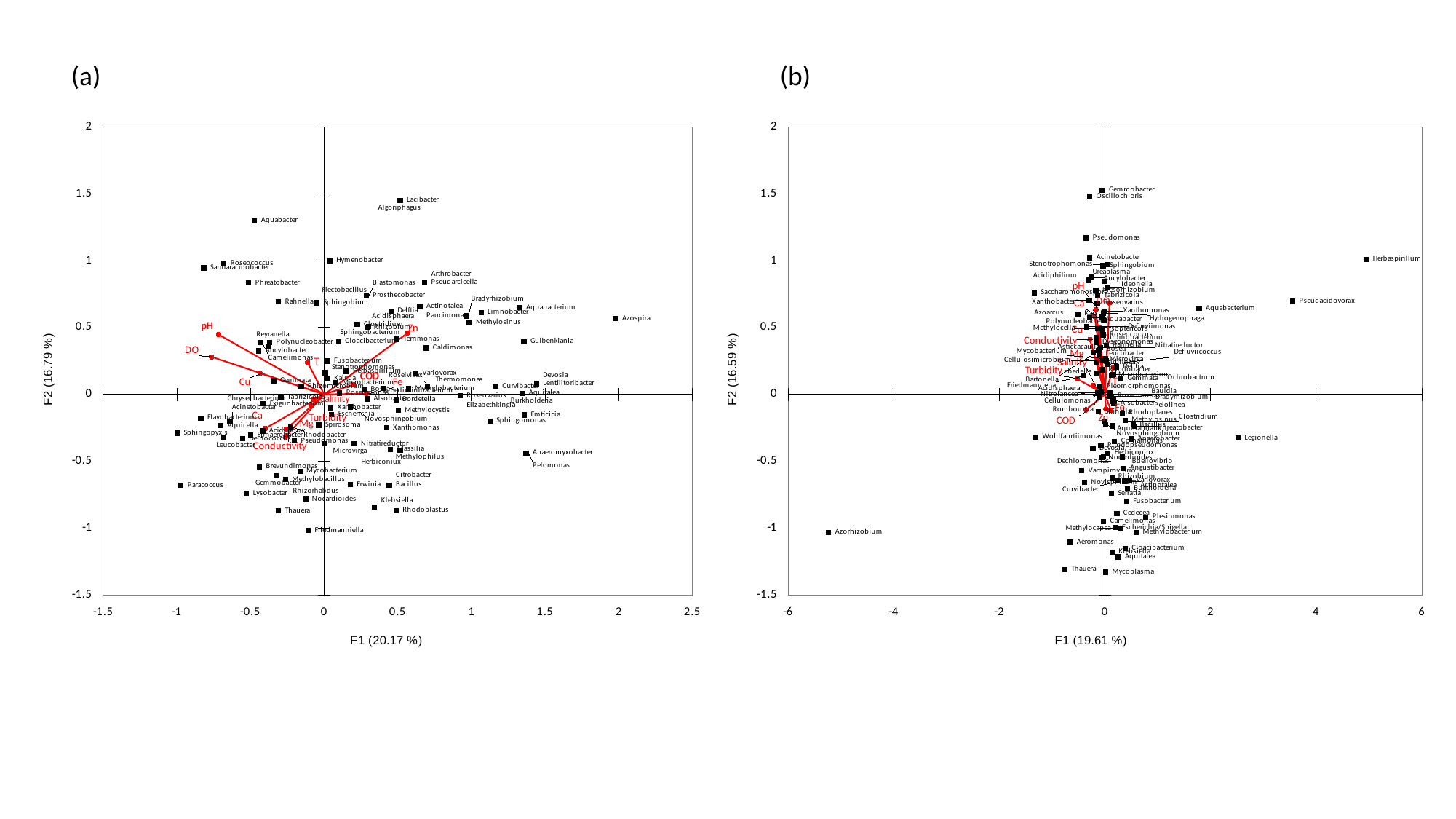
In chart (a), is the F1 value for Azospira greater or less than 1.5? greater In chart (b), is the F1 value for Azorhizobium greater or less than -4? less In chart (a), which labelled point has the highest F2 value? Lacibacter In chart (b), which labelled point has the highest F1 value? Herbaspirillum In chart (b), which labelled point has the lowest F1 value? Azorhizobium In chart (b), what is the label of the vertical axis? F2 (16.59 %) In chart (a), what is the label of the horizontal axis? F1 (20.17 %) In chart (b), which has the larger F1 value, Herbaspirillum or Pseudacidovorax? Herbaspirillum In chart (a), which labelled point has the lowest F2 value? Friedmanniella In chart (a), which labelled point has the highest F1 value? Azospira In chart (a), is the F2 value for Aquabacter greater or less than 1? greater What kind of chart is chart (a)? scatter chart